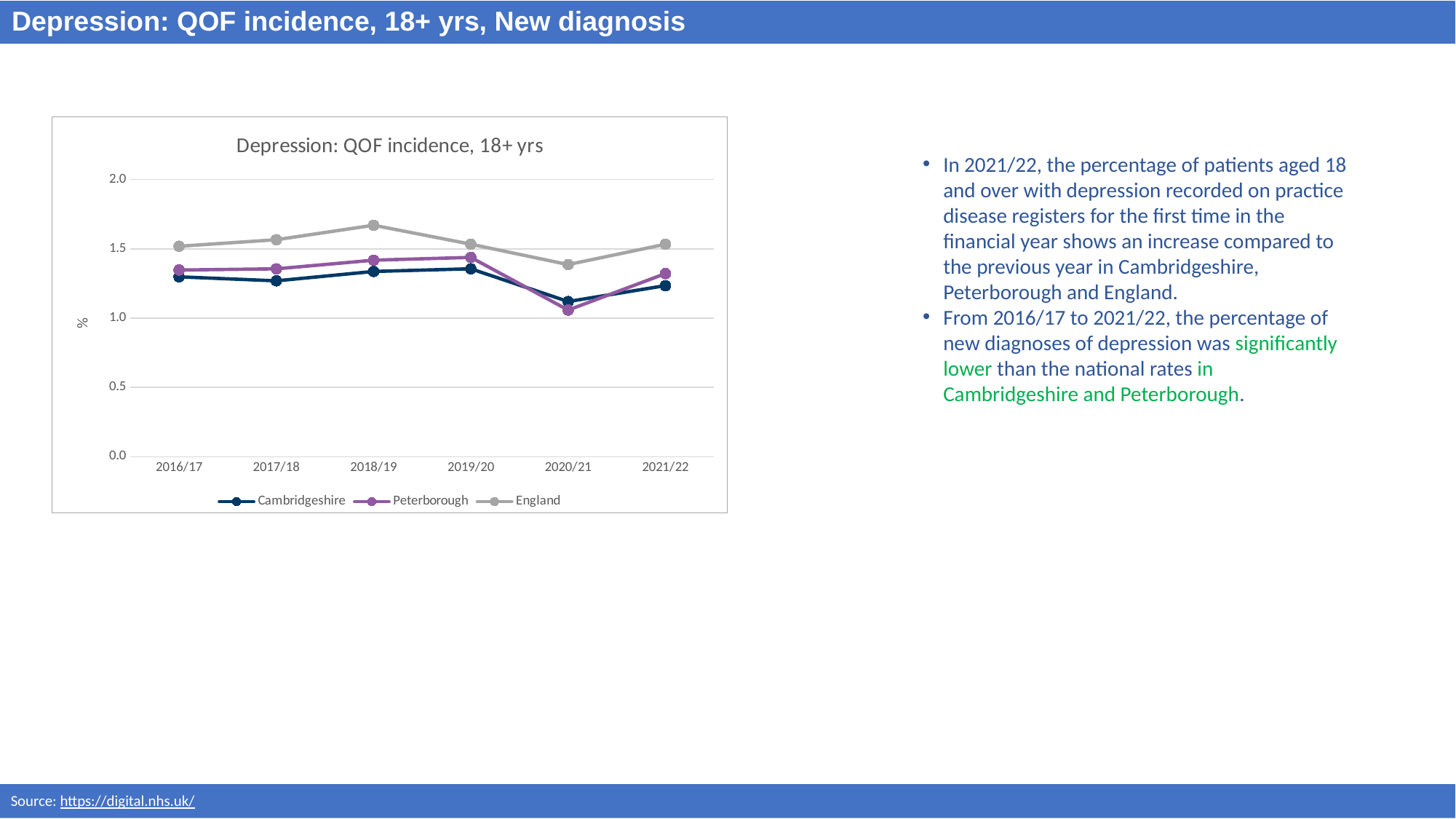
Is the value for Peterborough in 2016/17 greater or less than 1.5? less What is the label on the chart's y axis? % What kind of chart is shown on the slide? Line chart Does the England series rise or fall between 2019/20 and 2020/21? Fall In which year does the England series reach its highest value? 2018/19 Is the value for Cambridgeshire in 2020/21 greater or less than 1.0? greater In 2016/17, which is larger: the England value or the Cambridgeshire value? England How many series does the chart's legend list? 3 In which year does the England series reach its lowest value? 2020/21 Is the value for England in 2018/19 greater or less than 1.5? greater How many financial years are plotted along the x axis? 6 In which year is the Peterborough value lowest? 2020/21